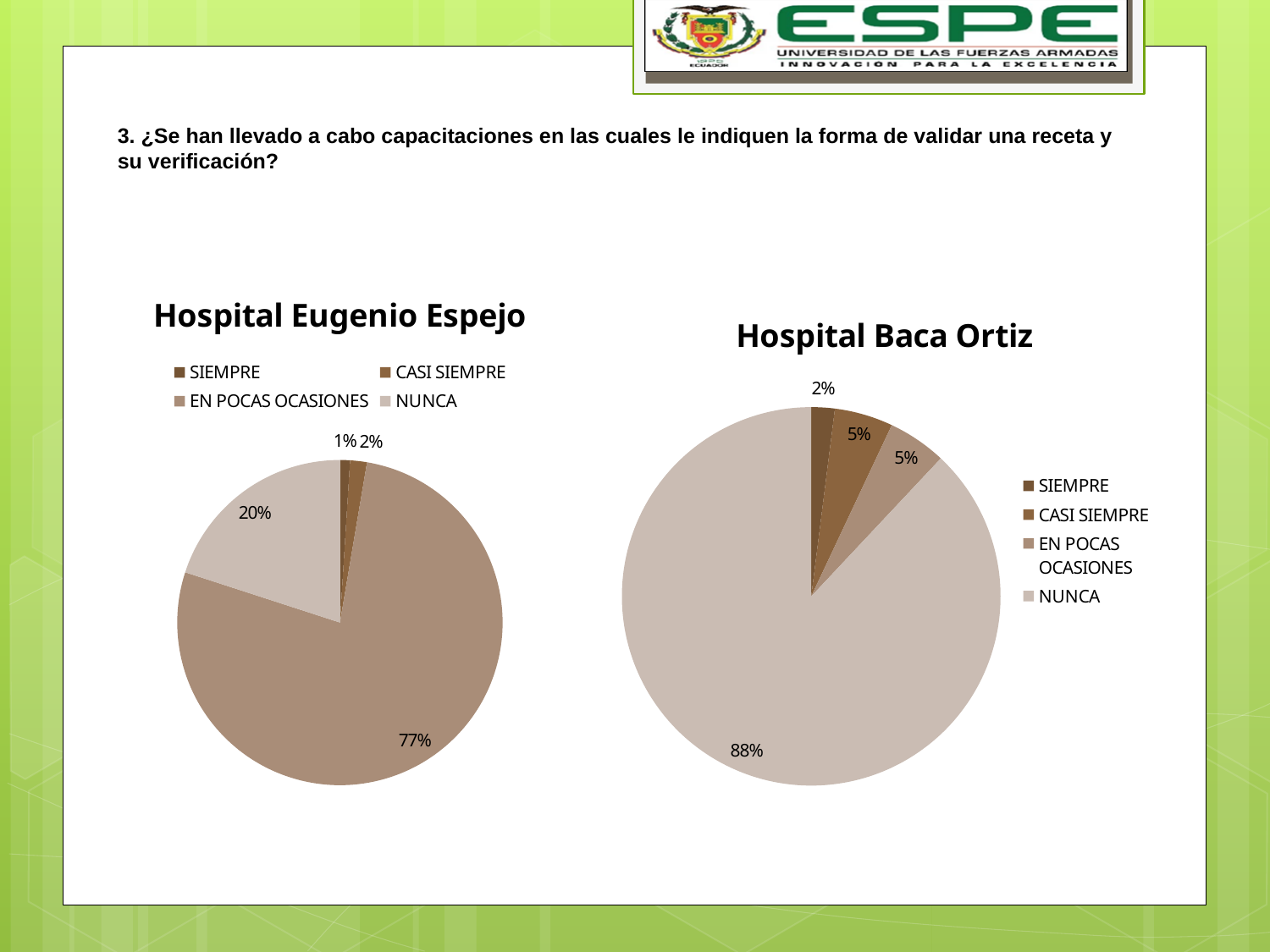
How many categories does the legend of the Hospital Baca Ortiz chart list? 4 In the Hospital Baca Ortiz chart, what share is labelled for NUNCA? 88% In the Hospital Baca Ortiz chart, which category has the smallest slice? SIEMPRE In the Hospital Baca Ortiz chart, what share is labelled for SIEMPRE? 2% What is the title of the chart on the right side of the slide? Hospital Baca Ortiz In the Hospital Eugenio Espejo chart, what share is labelled for NUNCA? 20% In the Hospital Eugenio Espejo chart, what is the difference between the EN POCAS OCASIONES share and the NUNCA share? 57% What kind of chart is the Hospital Eugenio Espejo chart? Pie chart In the Hospital Eugenio Espejo chart, which category has the largest slice? EN POCAS OCASIONES Which is larger: the NUNCA share in the Hospital Baca Ortiz chart or the NUNCA share in the Hospital Eugenio Espejo chart? Hospital Baca Ortiz In the Hospital Eugenio Espejo chart, what share is labelled for SIEMPRE? 1% In the Hospital Eugenio Espejo chart, what share is labelled for EN POCAS OCASIONES? 77%